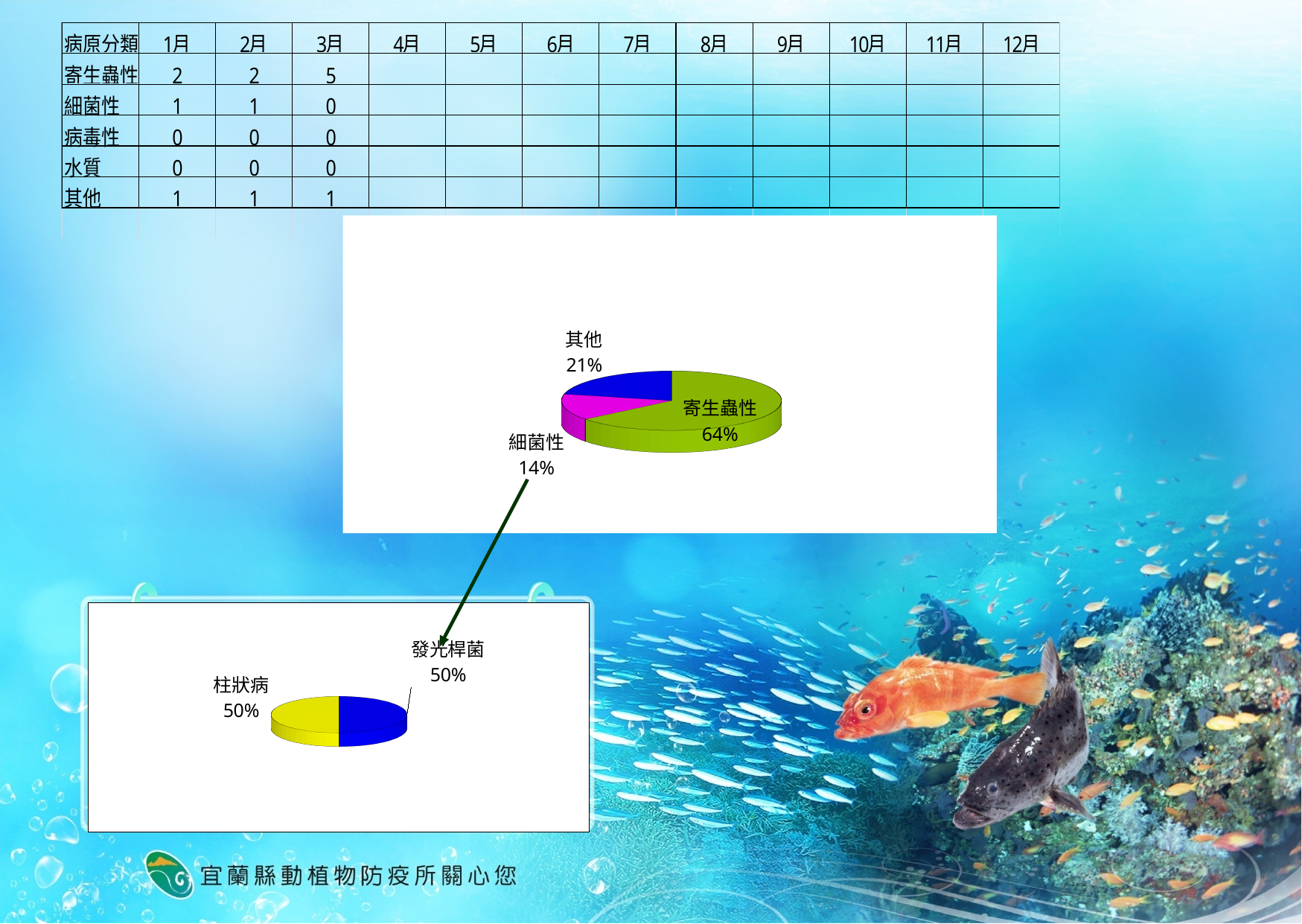
In the upper pie chart, what share does 寄生蟲性 have? 64% In the upper pie chart, what share does 其他 have? 21% In the upper pie chart, what share does 細菌性 have? 14% How many slices does the lower pie chart have? 2 In the upper pie chart, which category has the smallest slice? 細菌性 In the upper pie chart, how many percentage points larger is 寄生蟲性 than 其他? 43 In the lower pie chart, what share does 柱狀病 have? 50% In the upper pie chart, what colour is the 寄生蟲性 slice? green What kind of chart is the upper chart? pie chart In the upper pie chart, which category has the largest slice? 寄生蟲性 How many slices does the upper pie chart have? 3 In the upper pie chart, which is larger, 其他 or 細菌性? 其他